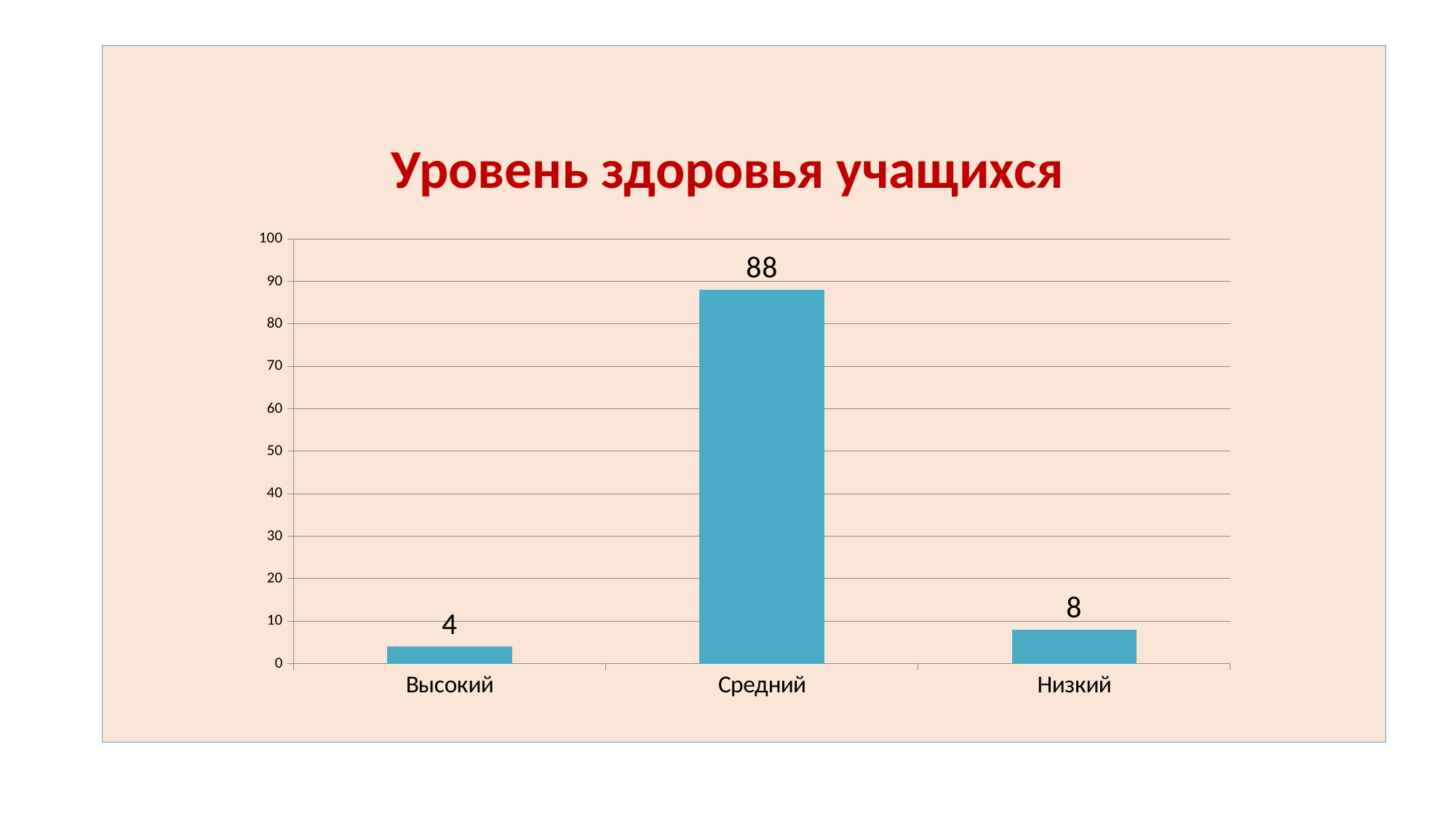
What is the value for Высокий? 4 Is the value for Средний greater or less than 50? greater What kind of chart is shown on the slide? bar chart What is the difference between the values for Средний and Низкий? 80 How many categories are shown on the x axis? 3 What is the difference between the values for Низкий and Высокий? 4 Which is larger, the value for Низкий or the value for Высокий? Низкий What is the value for Низкий? 8 Which category has the highest value? Средний What is the title of the slide? Уровень здоровья учащихся Which category has the lowest value? Высокий What is the value for Средний? 88